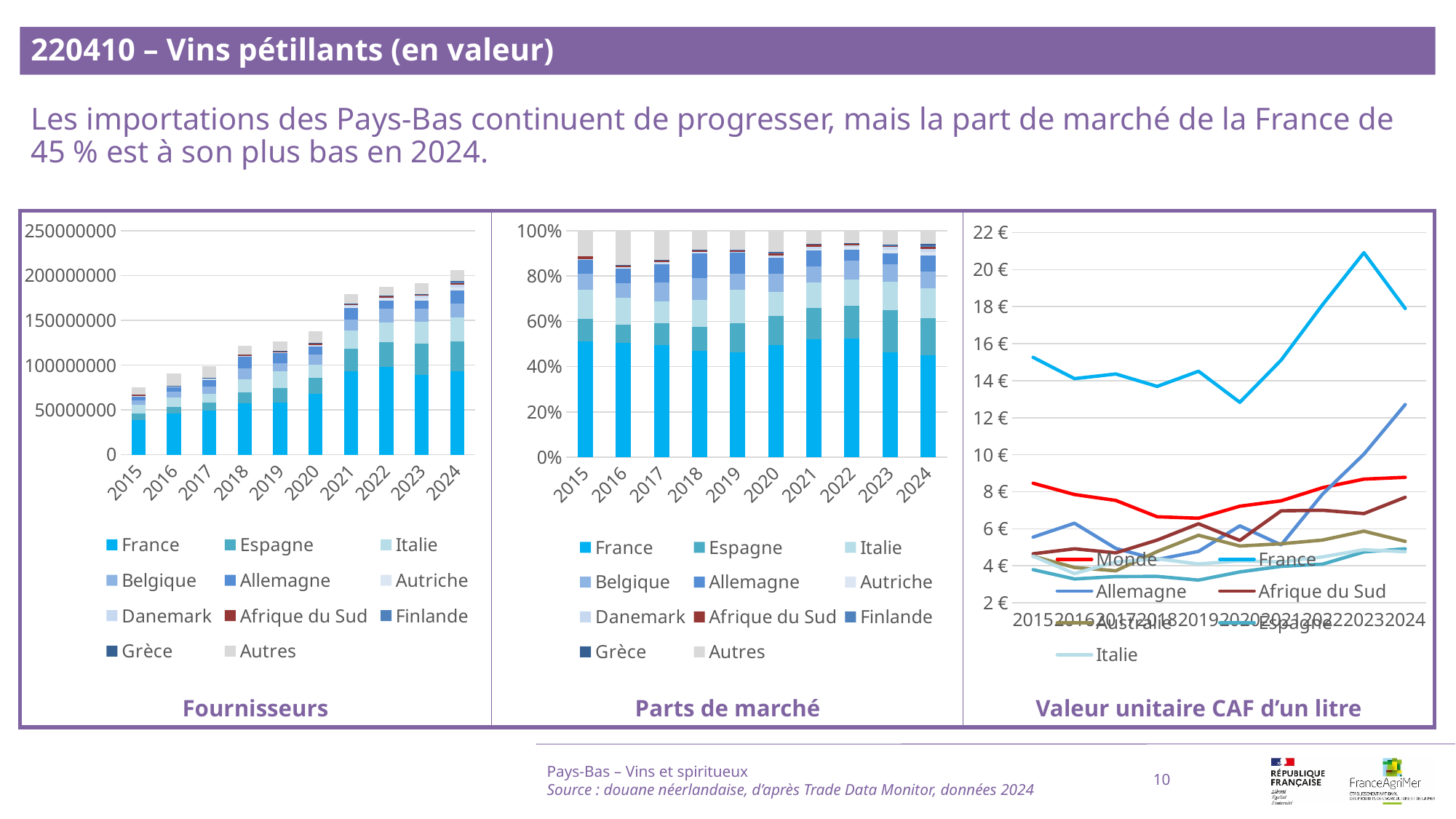
In the 'Parts de marché' chart, is the share of France in 2024 greater or less than 50%? less In the 'Fournisseurs' chart, is the total for 2021 greater or less than 150000000? greater In the 'Valeur unitaire CAF d'un litre' chart, is the value for France in 2023 greater or less than 20 €? greater How many series does the legend of the 'Parts de marché' chart list? 11 In the 'Valeur unitaire CAF d'un litre' chart, which series has the highest value in 2023? France How many series does the legend of the 'Valeur unitaire CAF d'un litre' chart list? 7 How many years are shown on the x axis of the 'Fournisseurs' chart? 10 In the 'Fournisseurs' chart, which year has the highest total stacked bar? 2024 In the 'Fournisseurs' chart, which year has the lowest total stacked bar? 2015 What kind of chart is the 'Fournisseurs' chart? stacked bar chart What kind of chart is the 'Valeur unitaire CAF d'un litre' chart? line chart